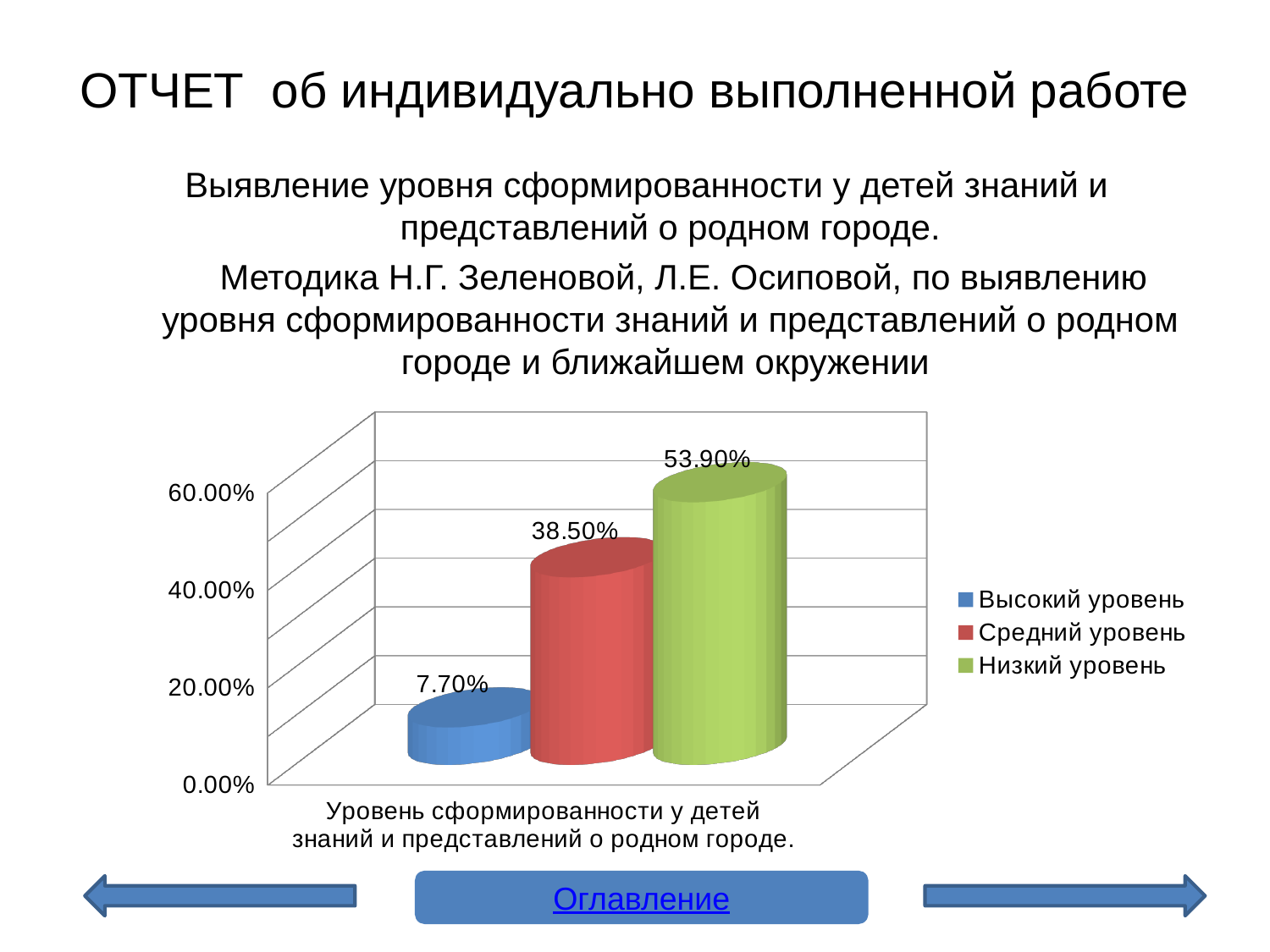
What is the value for Высокий уровень? 7.70% What is the value for Низкий уровень? 53.90% What is the difference between the values for Низкий уровень and Средний уровень? 15.40% Which is larger, the value for Средний уровень or the value for Высокий уровень? Средний уровень What is the value for Средний уровень? 38.50% Is the value for Низкий уровень greater or less than 40.00%? greater What is the difference between the values for Средний уровень and Высокий уровень? 30.80% What colour is the bar for Низкий уровень? green What kind of chart is shown on the slide? bar chart Which series has the lowest value? Высокий уровень How many series does the legend list? 3 Which series has the highest value? Низкий уровень